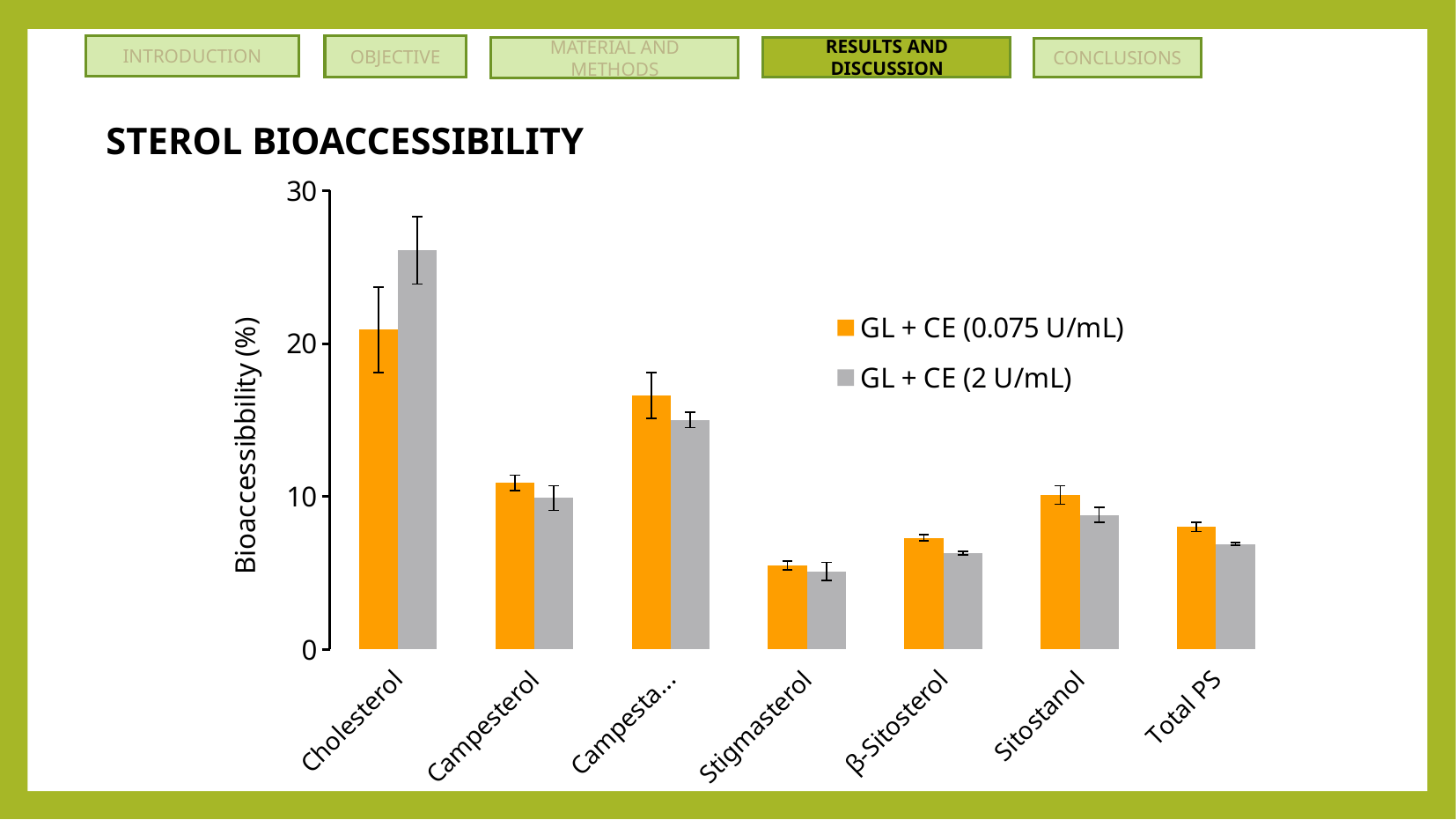
Which category has the highest bioaccessibility for GL + CE (0.075 U/mL)? Cholesterol For Sitostanol, which series has the larger bioaccessibility, GL + CE (0.075 U/mL) or GL + CE (2 U/mL)? GL + CE (0.075 U/mL) Is the bioaccessibility of Total PS for GL + CE (2 U/mL) greater or less than 10? less Is the bioaccessibility of Cholesterol for GL + CE (2 U/mL) greater or less than 20? greater For Cholesterol, which series has the larger bioaccessibility, GL + CE (0.075 U/mL) or GL + CE (2 U/mL)? GL + CE (2 U/mL) How many series does the legend list? 2 Is the bioaccessibility of Stigmasterol for GL + CE (0.075 U/mL) greater or less than 10? less How many sterol categories are shown on the x axis? 7 What kind of chart is shown on the slide? bar chart Which category has the lowest bioaccessibility for GL + CE (2 U/mL)? Stigmasterol Which category has the highest bioaccessibility for GL + CE (2 U/mL)? Cholesterol What is the label of the y axis? Bioaccessibbility (%)